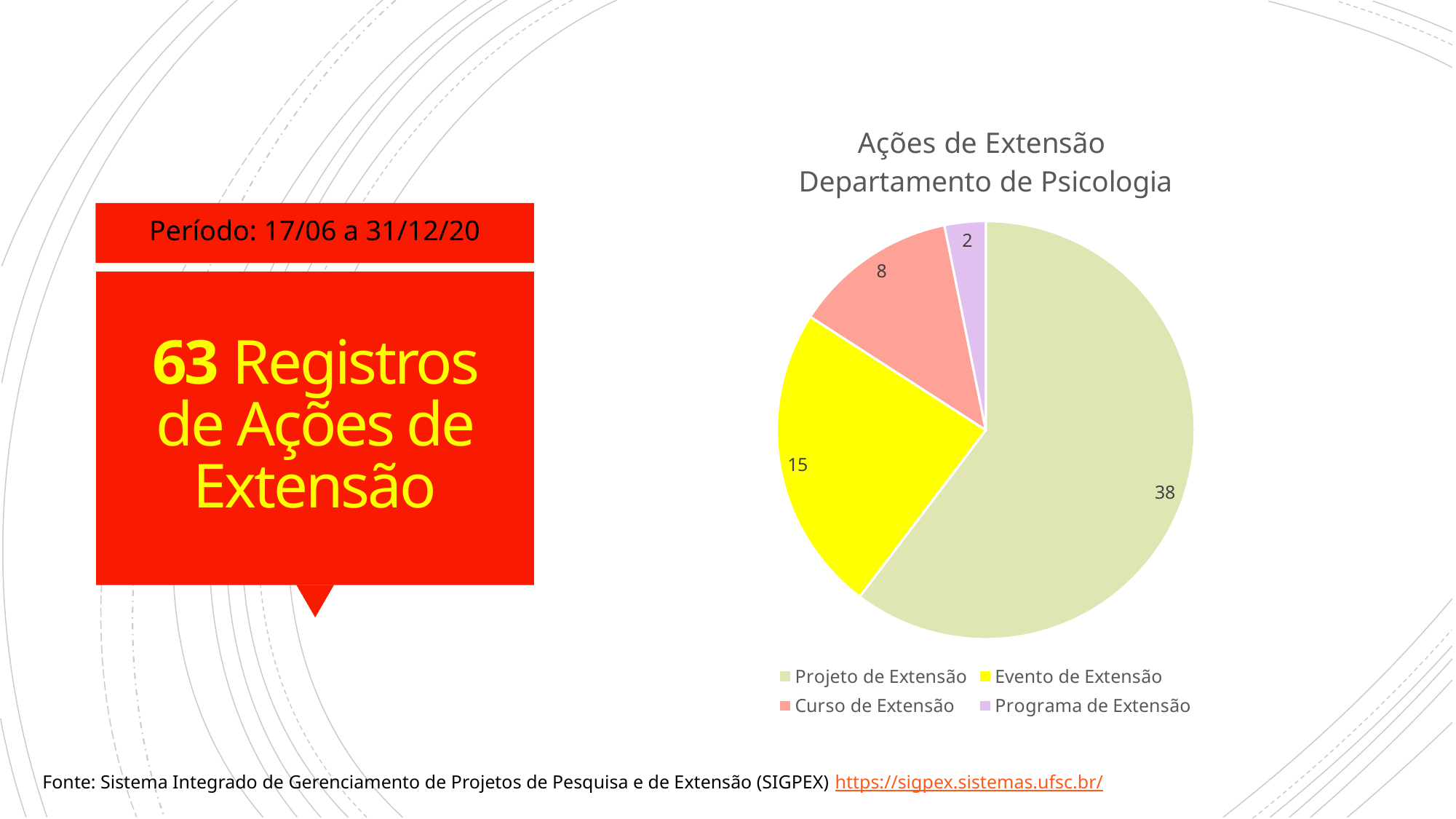
Which category has the largest slice? Projeto de Extensão What is the difference between the values for Projeto de Extensão and Evento de Extensão? 23 What type of chart is shown on the slide? pie chart What is the title of the chart? Ações de Extensão Departamento de Psicologia What is the value for Curso de Extensão? 8 How many entries does the legend list? 4 How many slices does the pie chart have? 4 Which category has the smallest slice? Programa de Extensão What is the value for Projeto de Extensão? 38 Which is larger, Curso de Extensão or Evento de Extensão? Evento de Extensão What is the value for Evento de Extensão? 15 What is the value for Programa de Extensão? 2